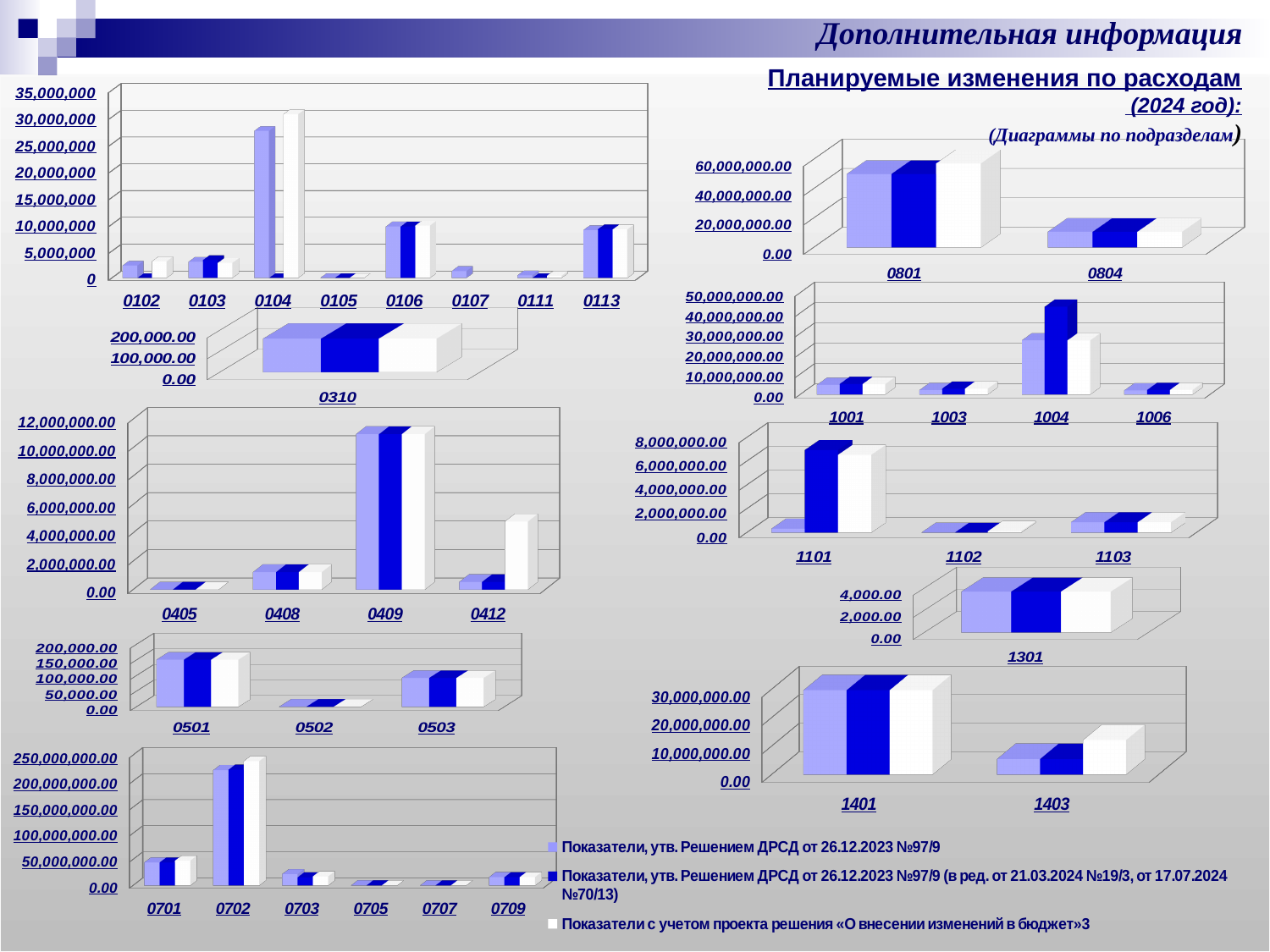
In the chart with categories 1101 through 1103, which category has the highest bars? 1101 How many series does the legend at the bottom of the slide list? 3 In the top-left chart with categories 0102 through 0113, how many categories are shown on the x axis? 8 What kind of chart is used for the categories 0102 through 0113 at the top left of the slide? bar chart In the chart with categories 0801 and 0804, which category has the larger values? 0801 In the chart with categories 0701 through 0709, which category has the highest bars? 0702 How many categories are shown in the chart with categories 0501 through 0503? 3 In the top-left chart with categories 0102 through 0113, which category has the highest bars? 0104 In the chart with categories 0701 through 0709, is the value of the white bar for 0702 greater or less than 150,000,000.00? greater In the chart with categories 1401 and 1403, is the value for 1401 greater or less than 20,000,000.00? greater